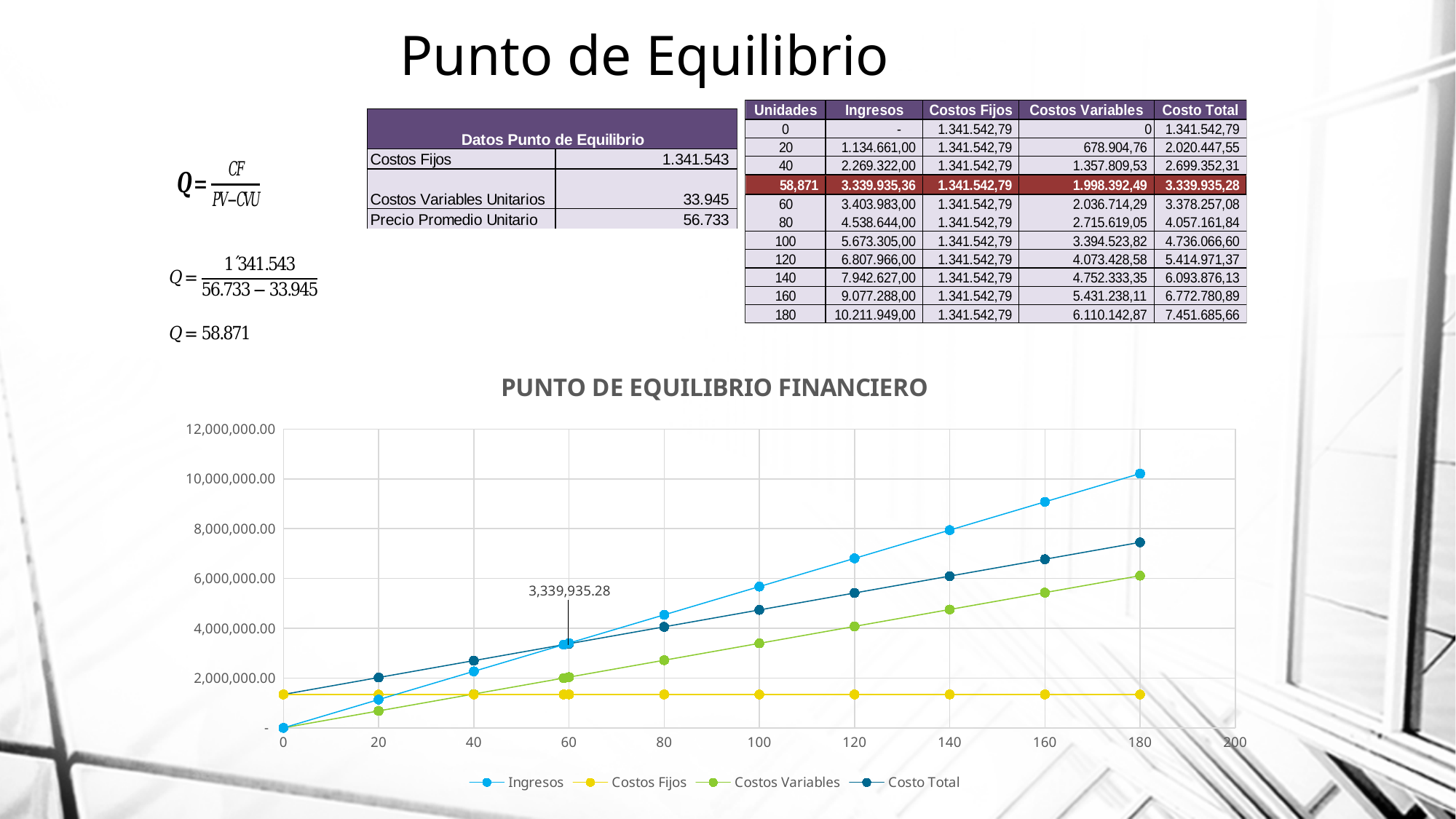
What type of chart is shown under the title PUNTO DE EQUILIBRIO FINANCIERO? Line chart How many series does the legend of the PUNTO DE EQUILIBRIO FINANCIERO chart list? 4 Does the Costos Fijos line rise, fall or stay flat as units increase? Stays flat At 20 units, which is larger: Costo Total or Ingresos? Costo Total Which series has the lowest value at 180 units? Costos Fijos What value is shown by the data label at the break-even point in the chart? 3,339,935.28 Is the value of Costos Variables at 100 units greater or less than 4,000,000.00? less Is the value of Costo Total at 180 units greater or less than 8,000,000.00? less What is the title of the chart on the slide? PUNTO DE EQUILIBRIO FINANCIERO Is the value of Ingresos at 180 units greater or less than 10,000,000.00? greater At 180 units, which is larger: Ingresos or Costo Total? Ingresos Does the Ingresos line rise or fall as units increase along the x axis? Rises